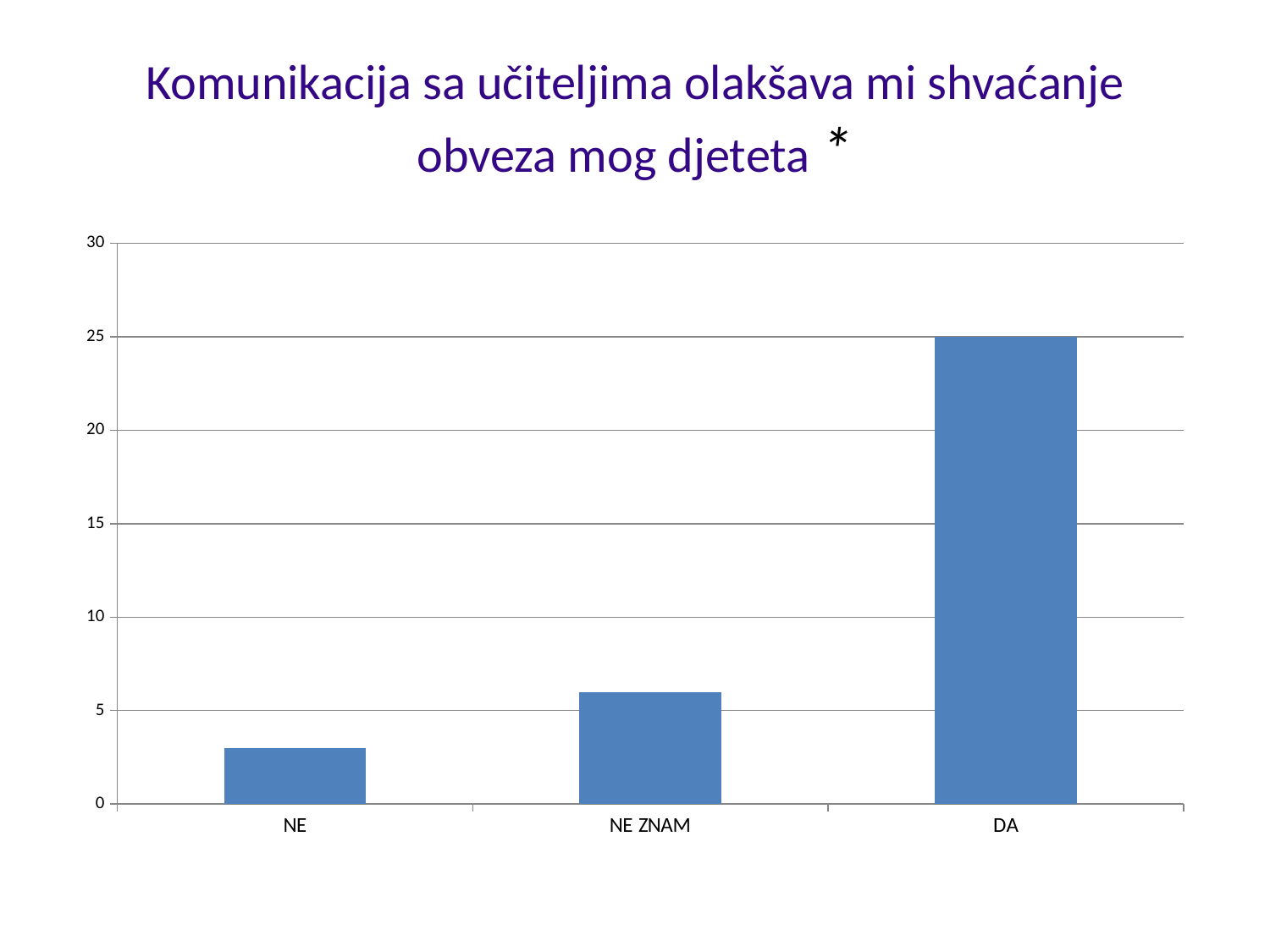
Which category has the highest value in the chart? DA Which is larger, the value for NE or the value for NE ZNAM? NE ZNAM Is the value for NE ZNAM greater or less than 5? greater Is the value for NE ZNAM greater or less than 10? less Is the value for DA greater or less than 20? greater Do the values rise or fall moving from NE to DA along the x axis? rise How many categories are shown on the x axis of the chart? 3 Which category has the lowest value in the chart? NE What is the value for DA in the chart? 25 What is the title of the slide above the chart? Komunikacija sa učiteljima olakšava mi shvaćanje obveza mog djeteta * What kind of chart is shown on the slide? bar chart